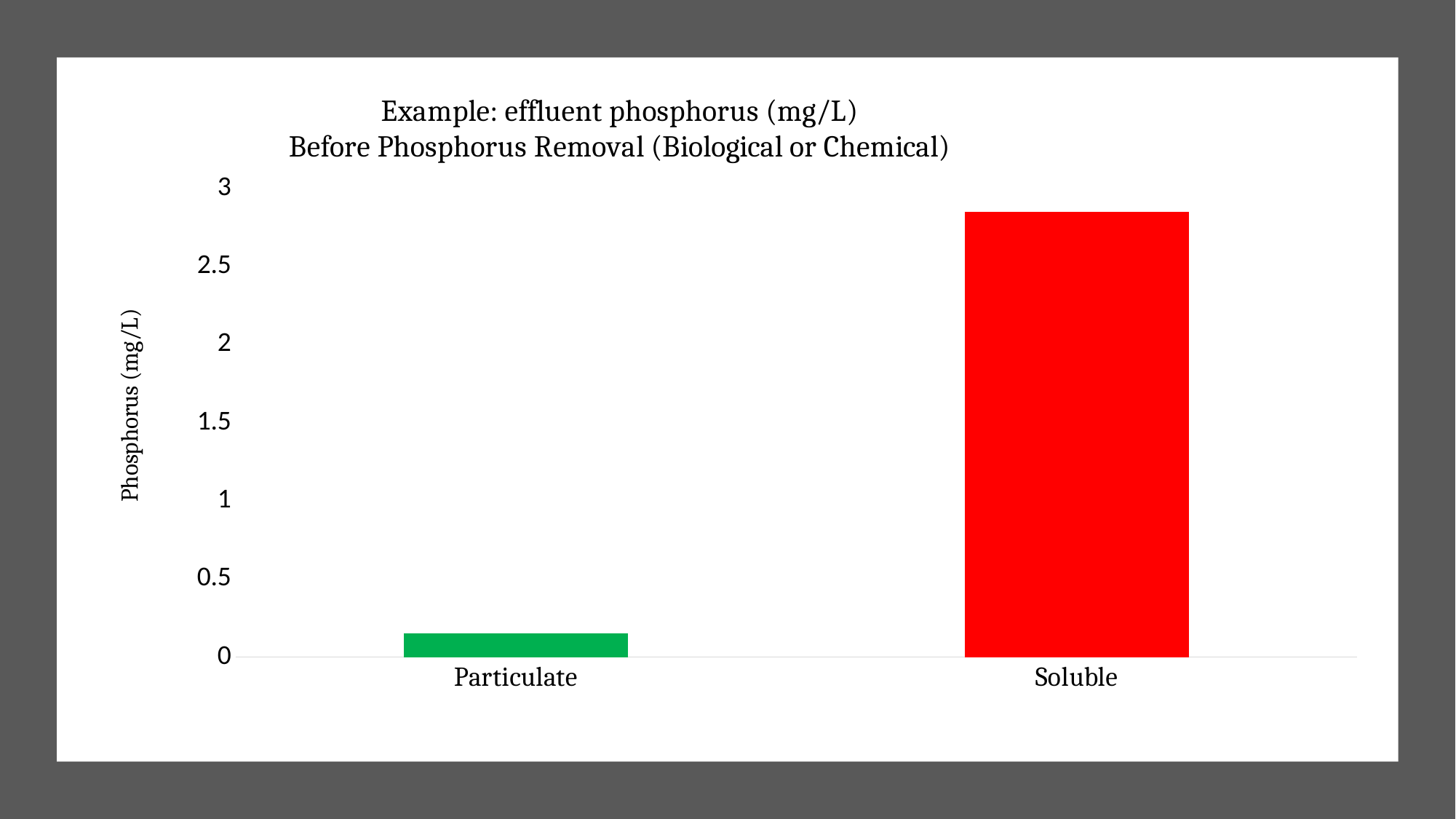
Which category has the highest phosphorus value? Soluble What colour is the bar for Soluble? red Which is larger, the value for Particulate or the value for Soluble? Soluble Is the value for Particulate greater or less than 0.5? less What is the label of the vertical axis? Phosphorus (mg/L) Is the value for Soluble greater or less than 1? greater How many categories are plotted on the chart? 2 What kind of chart is shown on the slide? bar chart Is the value for Soluble greater or less than 2.5? greater Which category has the lowest phosphorus value? Particulate